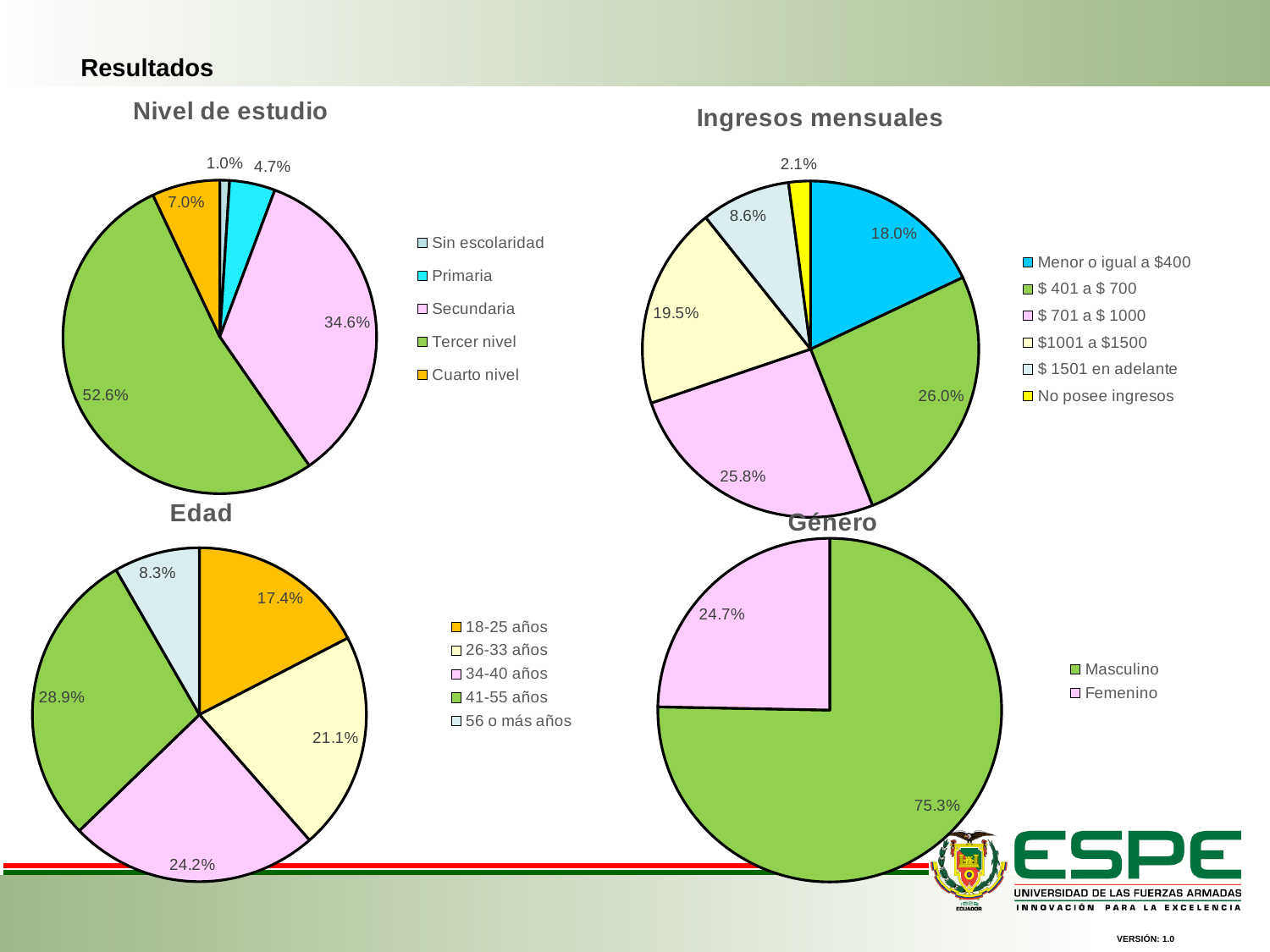
In the 'Edad' chart, which age group has the largest slice? 41-55 años What type of chart is used for 'Género'? Pie chart In the 'Nivel de estudio' chart, what share is labelled for Tercer nivel? 52.6% In the 'Nivel de estudio' chart, what is the difference between the Secundaria and Cuarto nivel shares? 27.6% In the 'Ingresos mensuales' chart, which category has the largest slice? $ 401 a $ 700 In the 'Género' chart, what share is labelled for Femenino? 24.7% In the 'Nivel de estudio' chart, which category has the smallest slice? Sin escolaridad How many categories does the legend of the 'Ingresos mensuales' chart list? 6 In the 'Edad' chart, which is larger: the share for 18-25 años or for 34-40 años? 34-40 años In the 'Ingresos mensuales' chart, what share is labelled for $1001 a $1500? 19.5% In the 'Ingresos mensuales' chart, what share is labelled for No posee ingresos? 2.1% In the 'Edad' chart, what share is labelled for 26-33 años? 21.1%